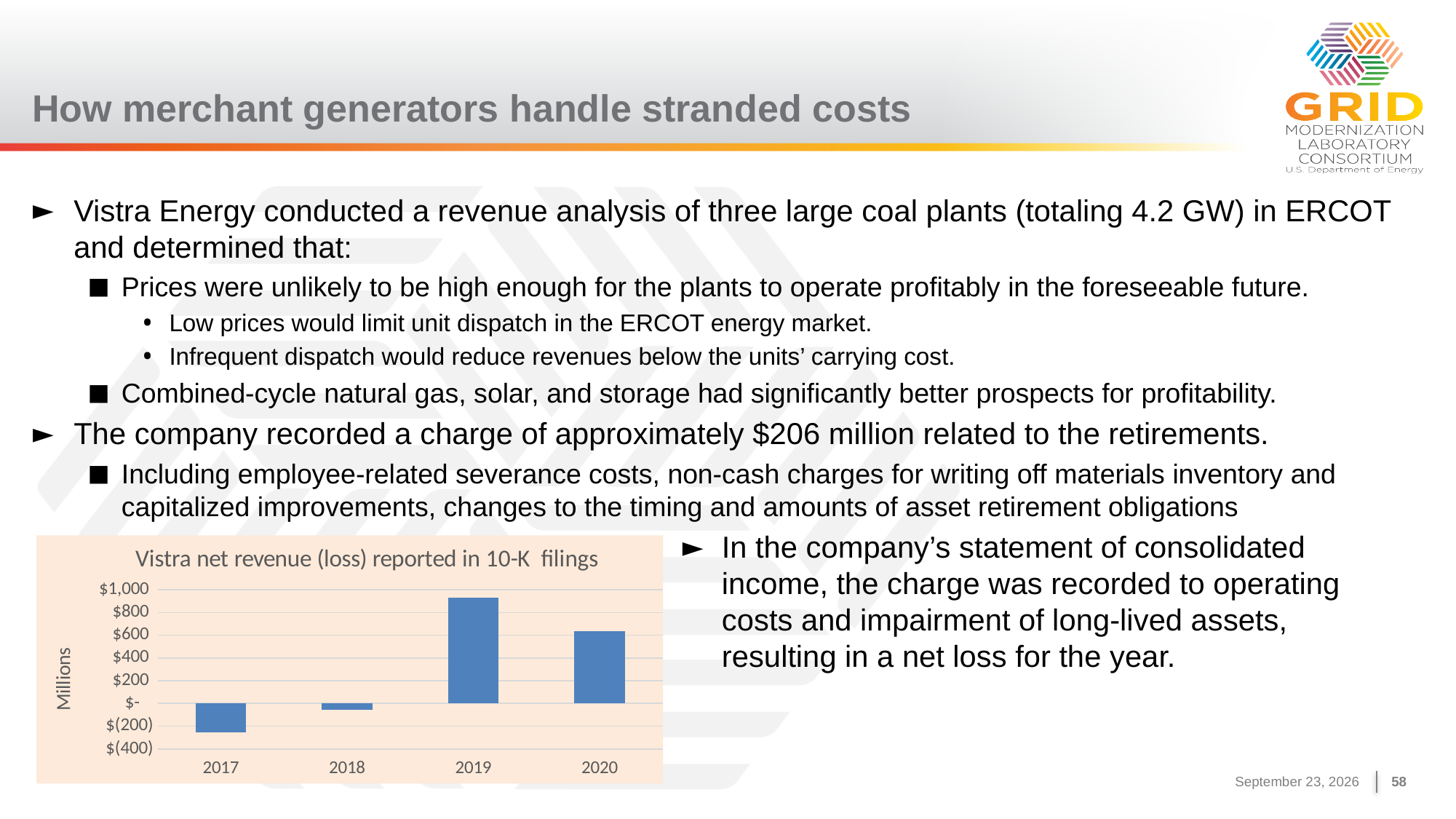
Does the net revenue rise or fall from 2018 to 2019? rise Which year has the highest net revenue in the chart? 2019 Which year has the larger net revenue, 2017 or 2018? 2018 What is the title of the chart? Vistra net revenue (loss) reported in 10-K filings What unit label is shown on the vertical axis of the chart? Millions Is the value for 2019 greater or less than $800? greater What kind of chart is shown on the slide? bar chart Is the value for 2017 greater or less than $-? less Is the value for 2020 greater or less than $800? less Which year has the lowest net revenue in the chart? 2017 Which year has the larger net revenue, 2019 or 2020? 2019 How many years are shown on the x axis of the chart? 4